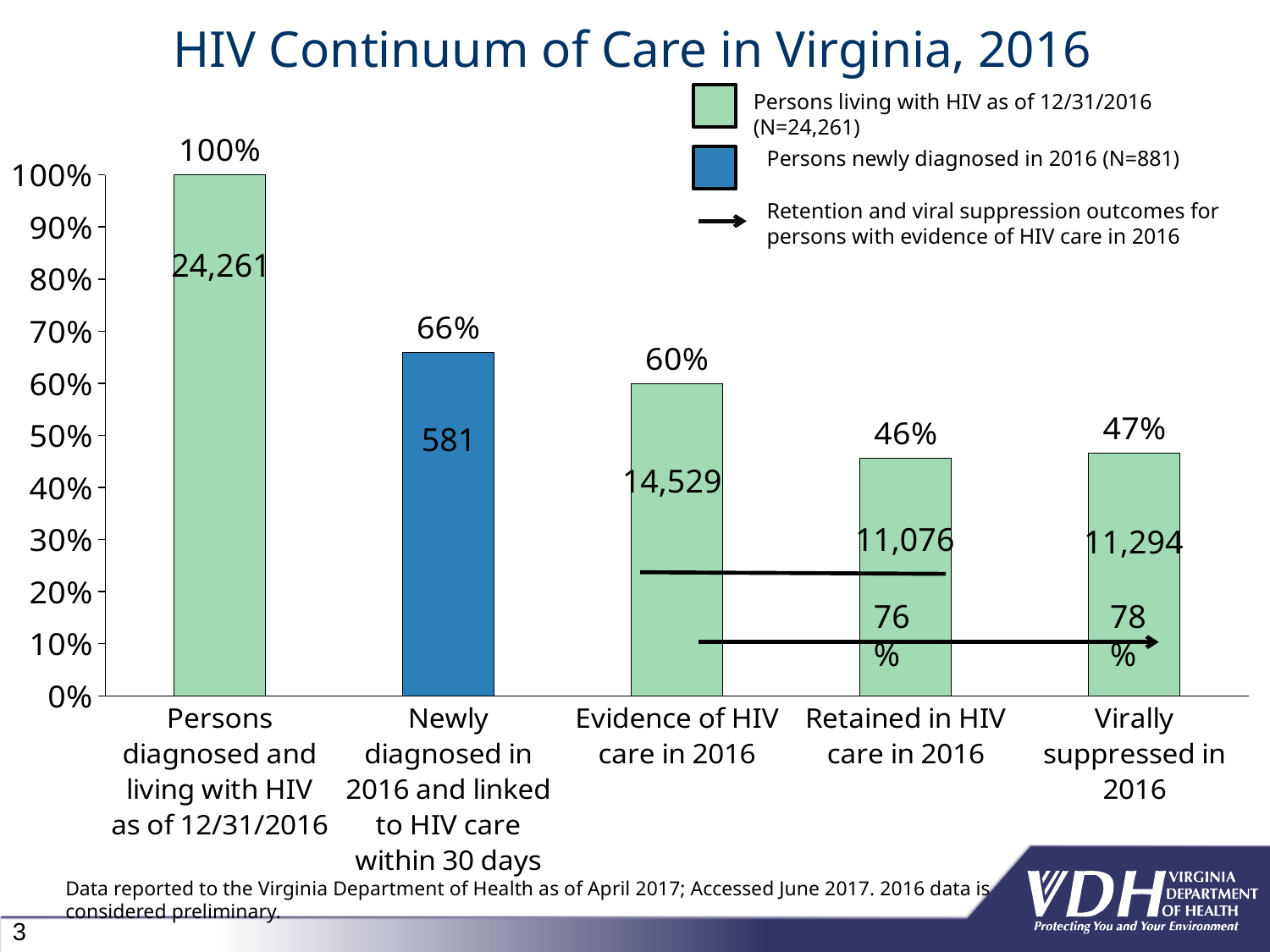
Which bar is coloured blue rather than green? Newly diagnosed in 2016 and linked to HIV care within 30 days What percentage is shown for the 'Evidence of HIV care in 2016' bar? 60% What is the difference in percentage points between the 'Newly diagnosed in 2016 and linked to HIV care within 30 days' bar and the 'Evidence of HIV care in 2016' bar? 6 Which is larger: the count for 'Retained in HIV care in 2016' or the count for 'Virally suppressed in 2016'? Virally suppressed in 2016 Which category has the highest percentage? Persons diagnosed and living with HIV as of 12/31/2016 What count is printed inside the 'Newly diagnosed in 2016 and linked to HIV care within 30 days' bar? 581 What is the title of the chart? HIV Continuum of Care in Virginia, 2016 What percentage is shown for the 'Retained in HIV care in 2016' bar? 46% What count is printed inside the 'Virally suppressed in 2016' bar? 11,294 Which category has the lowest percentage? Retained in HIV care in 2016 How many bars are plotted in the chart? 5 What type of chart is shown on the slide? Bar chart